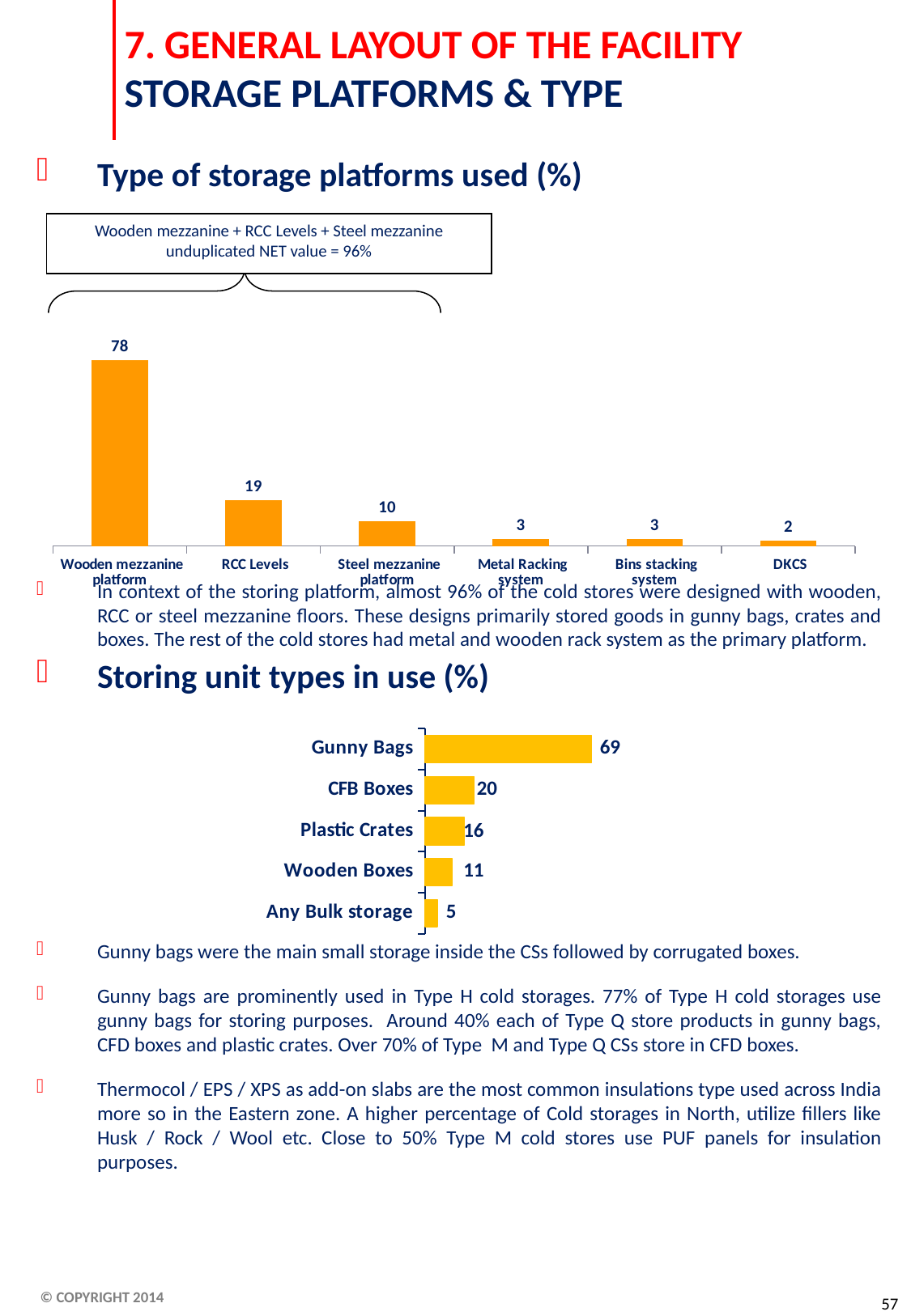
What type of chart is the 'Storing unit types in use (%)' chart? bar chart In the 'Storing unit types in use (%)' chart, which is larger, CFB Boxes or Wooden Boxes? CFB Boxes In the 'Type of storage platforms used (%)' chart, what is the value for RCC Levels? 19 In the 'Type of storage platforms used (%)' chart, do the values rise or fall from left to right? fall In the 'Type of storage platforms used (%)' chart, how many categories are shown? 6 In the 'Storing unit types in use (%)' chart, what is the value for Gunny Bags? 69 In the 'Storing unit types in use (%)' chart, what is the difference between Gunny Bags and CFB Boxes? 49 In the 'Type of storage platforms used (%)' chart, what is the value for Wooden mezzanine platform? 78 In the 'Storing unit types in use (%)' chart, which category has the highest value? Gunny Bags In the 'Type of storage platforms used (%)' chart, what is the difference between Wooden mezzanine platform and Steel mezzanine platform? 68 In the 'Storing unit types in use (%)' chart, what is the value for Plastic Crates? 16 In the 'Type of storage platforms used (%)' chart, which category has the lowest value? DKCS